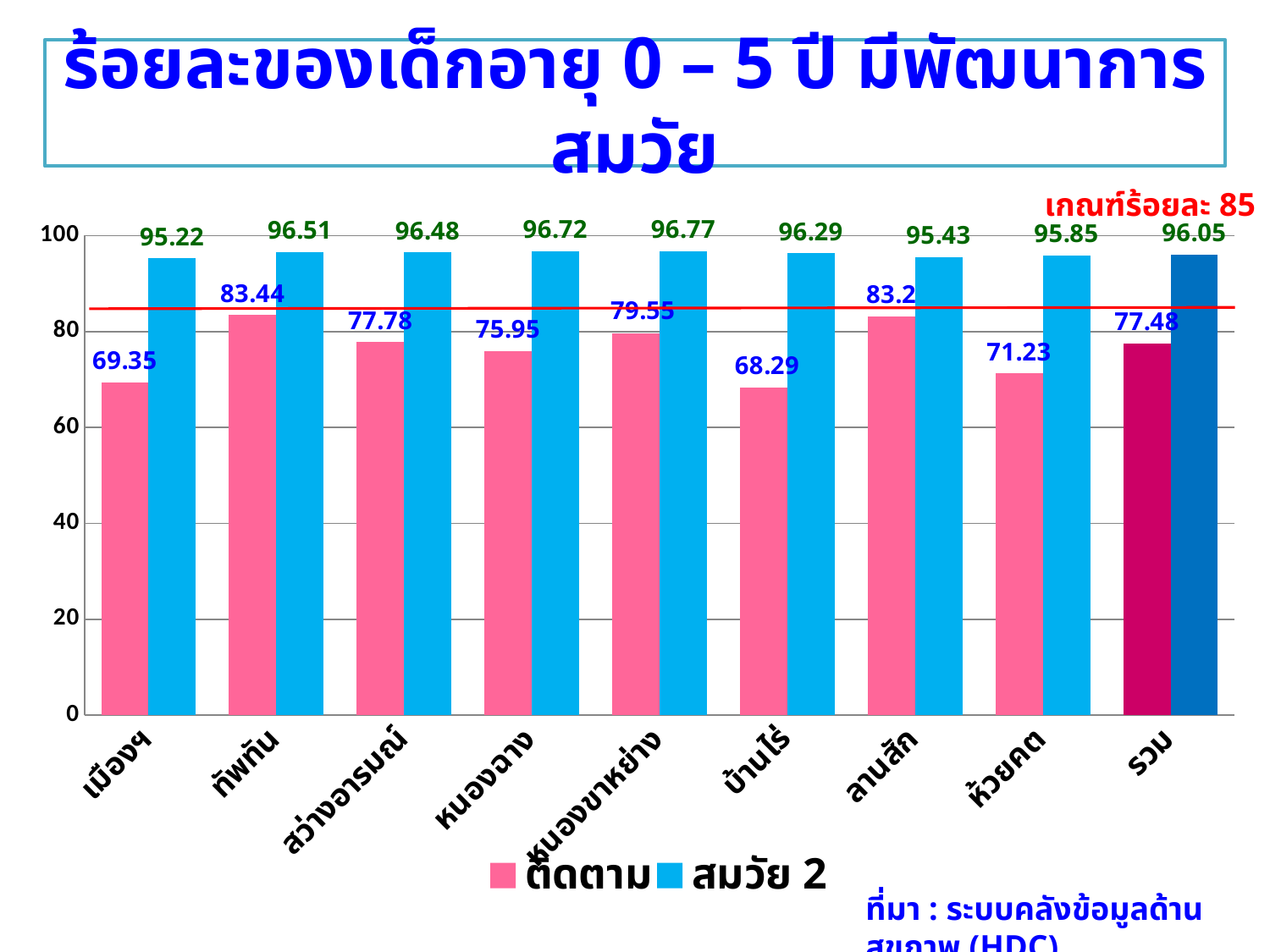
What is the difference between the สมวัย 2 and ติดตาม values for เมืองฯ? 25.87 Is the ติดตาม value for หนองฉาง greater or less than 80? less How many series does the legend list? 2 What is the สมวัย 2 value for หนองขาหย่าง? 96.77 Which category has the lowest ติดตาม value? บ้านไร่ What kind of chart is shown on the slide? bar chart What is the ติดตาม value for ทัพทัน? 83.44 How many categories are shown on the x axis? 9 What threshold value does the red horizontal line represent? 85 What is the ติดตาม value for รวม? 77.48 Which is larger, the ติดตาม value for ลานสัก or for ห้วยคต? ลานสัก Which category has the highest สมวัย 2 value? หนองขาหย่าง